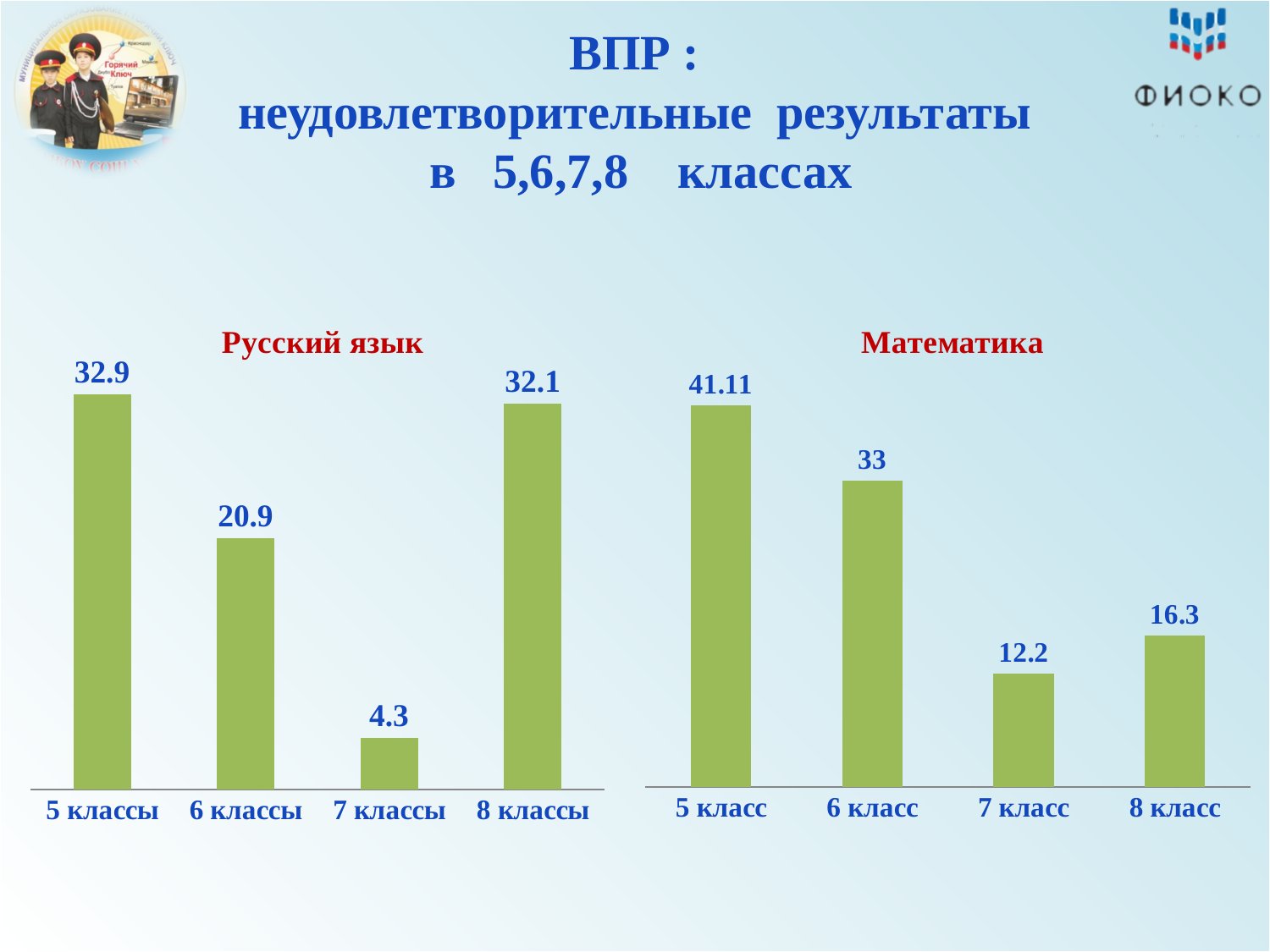
In the 'Русский язык' chart, what is the value for 7 классы? 4.3 In the 'Математика' chart, which category has the lowest value? 7 класс In the 'Русский язык' chart, what is the difference between the values for 6 классы and 7 классы? 16.6 In the 'Математика' chart, do the values rise or fall from 5 класс to 7 класс? fall In the 'Математика' chart, what is the value for 6 класс? 33 In the 'Русский язык' chart, which category has the highest value? 5 классы How many categories are shown in the 'Русский язык' chart? 4 In the 'Математика' chart, what is the value for 8 класс? 16.3 In the 'Математика' chart, what is the difference between the values for 5 класс and 6 класс? 8.11 In the 'Русский язык' chart, what is the value for 5 классы? 32.9 What kind of chart is the 'Математика' chart? bar chart In the 'Математика' chart, which is larger: the value for 7 класс or 8 класс? 8 класс